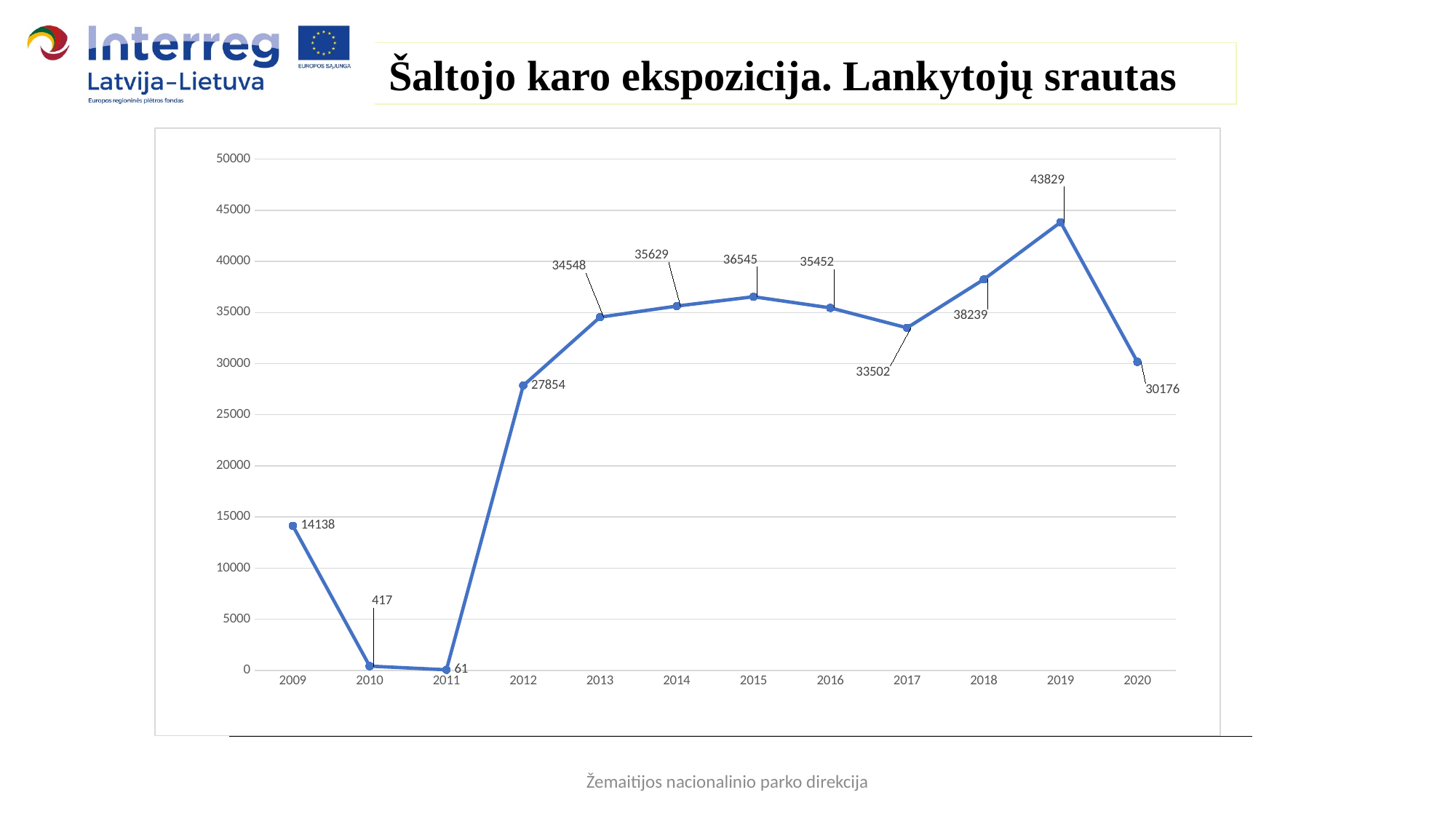
Which year has the highest value? 2019 What kind of chart is shown on the slide? line chart How many years are plotted on the x axis? 12 What is the value for 2010? 417 What is the value for 2019? 43829 Do the values rise or fall from 2019 to 2020? fall Is the value for 2018 greater or less than 35000? greater What is the difference between the values for 2009 and 2012? 13716 What is the difference between the values for 2019 and 2020? 13653 Which year has the lowest value? 2011 What is the value for 2012? 27854 Which is larger, the value for 2015 or the value for 2016? 2015